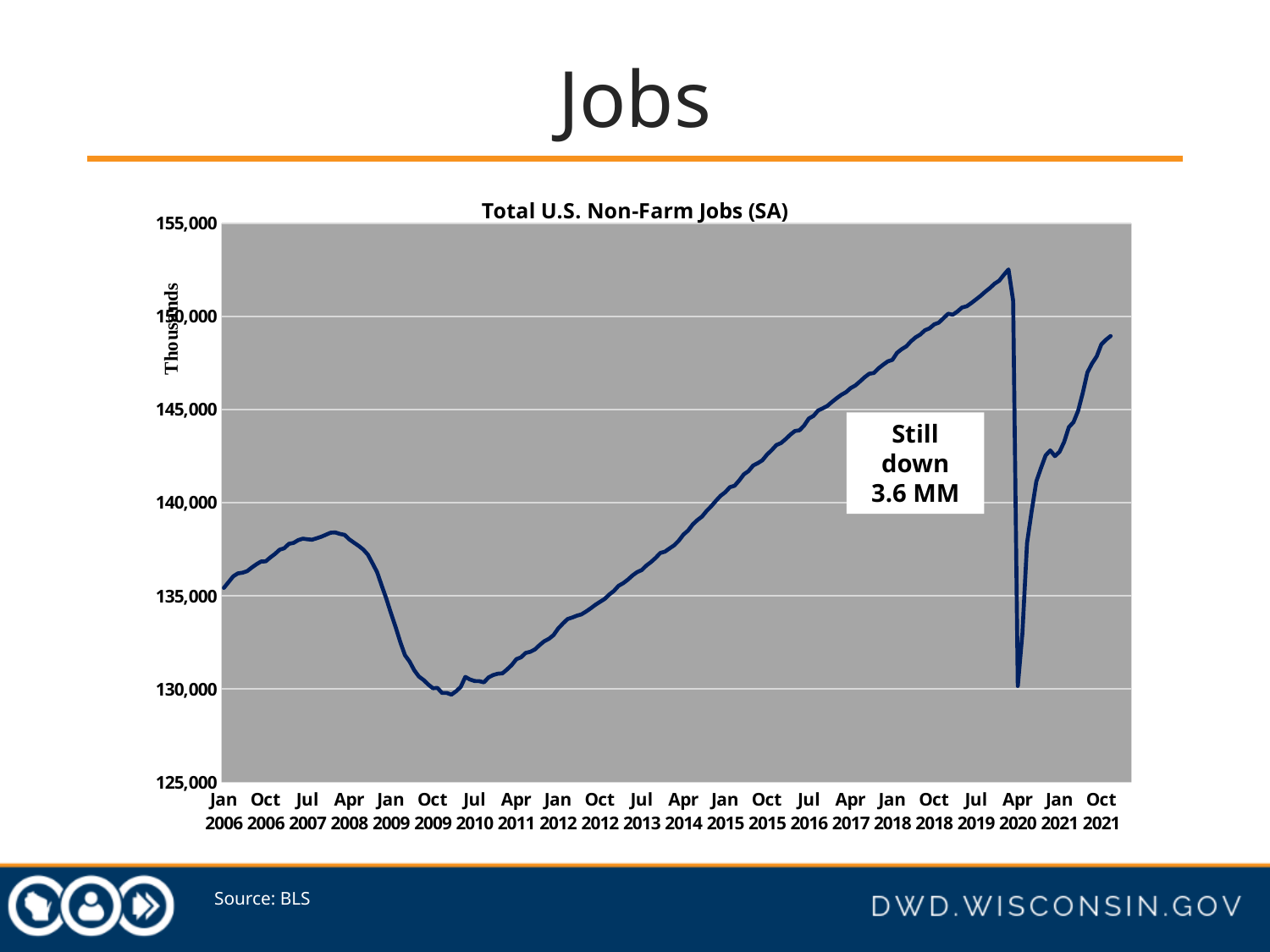
Do the values rise or fall between Jan 2008 and Jan 2010? fall Is the value for Oct 2021 greater or less than 150,000? less In which year does the line reach its lowest point? 2010 Is the value for Jan 2008 greater or less than 140,000? less Which is larger, the value for Jan 2019 or the value for Jan 2021? Jan 2019 What is the title of the chart? Total U.S. Non-Farm Jobs (SA) Is the value for Apr 2020 greater or less than 135,000? less Do the values rise or fall between Jan 2010 and Jan 2020? rise What does the text box inside the chart say? Still down 3.6 MM What kind of chart is shown on the slide? line chart